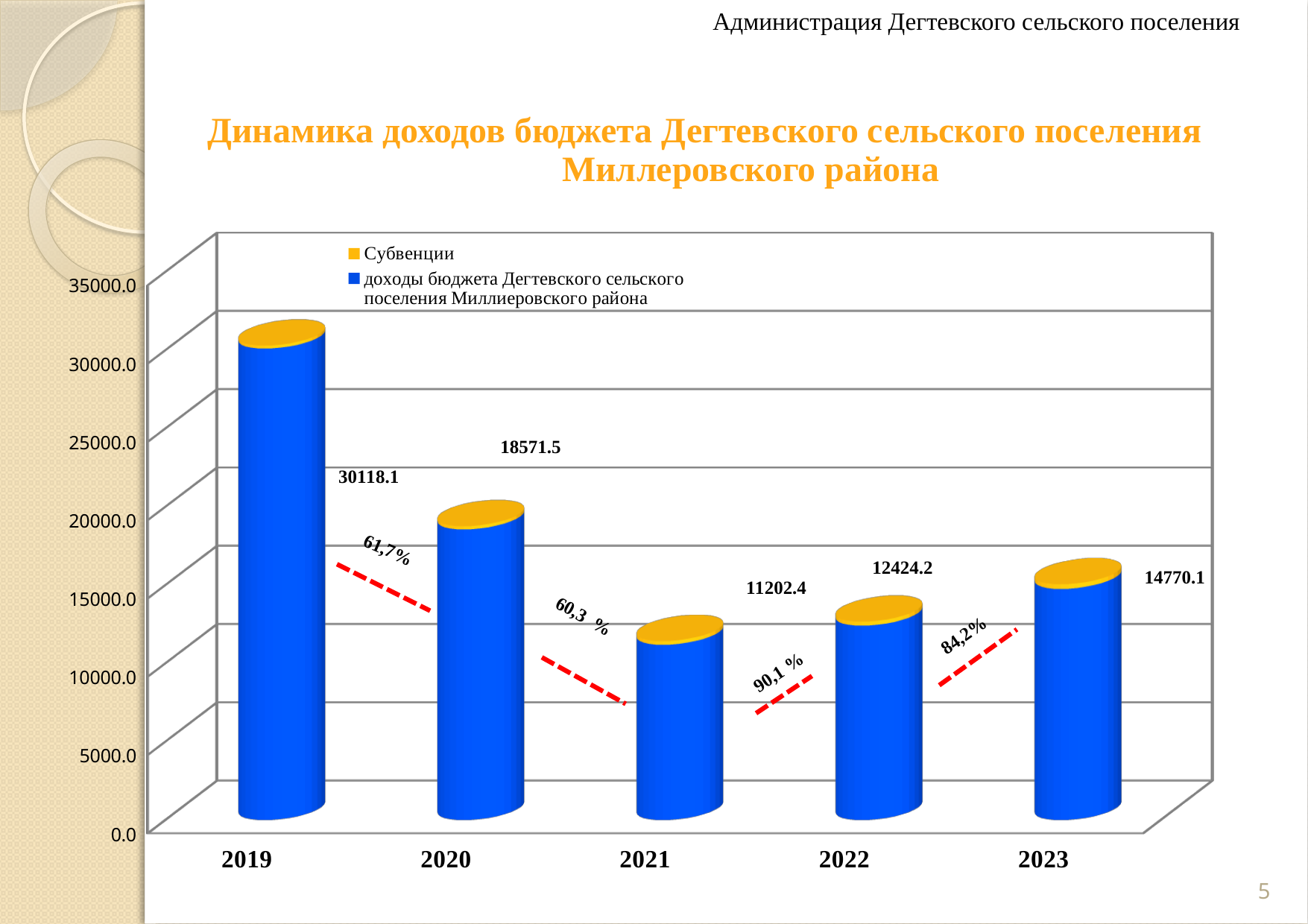
How many years are shown on the x axis? 5 What is the difference between the values for 2019 and 2020? 11546.6 What is the difference between the values for 2023 and 2022? 2345.9 Which year has the highest value? 2019 Is the value for 2020 greater or less than 20000.0? less What is the value labelled for 2023? 14770.1 Do the values rise or fall from 2019 to 2021? fall How many entries does the legend list? 2 Which year has the lowest value? 2021 What is the value labelled for 2021? 11202.4 What is the budget income value shown for 2019? 30118.1 Which is larger, the value for 2022 or the value for 2021? 2022